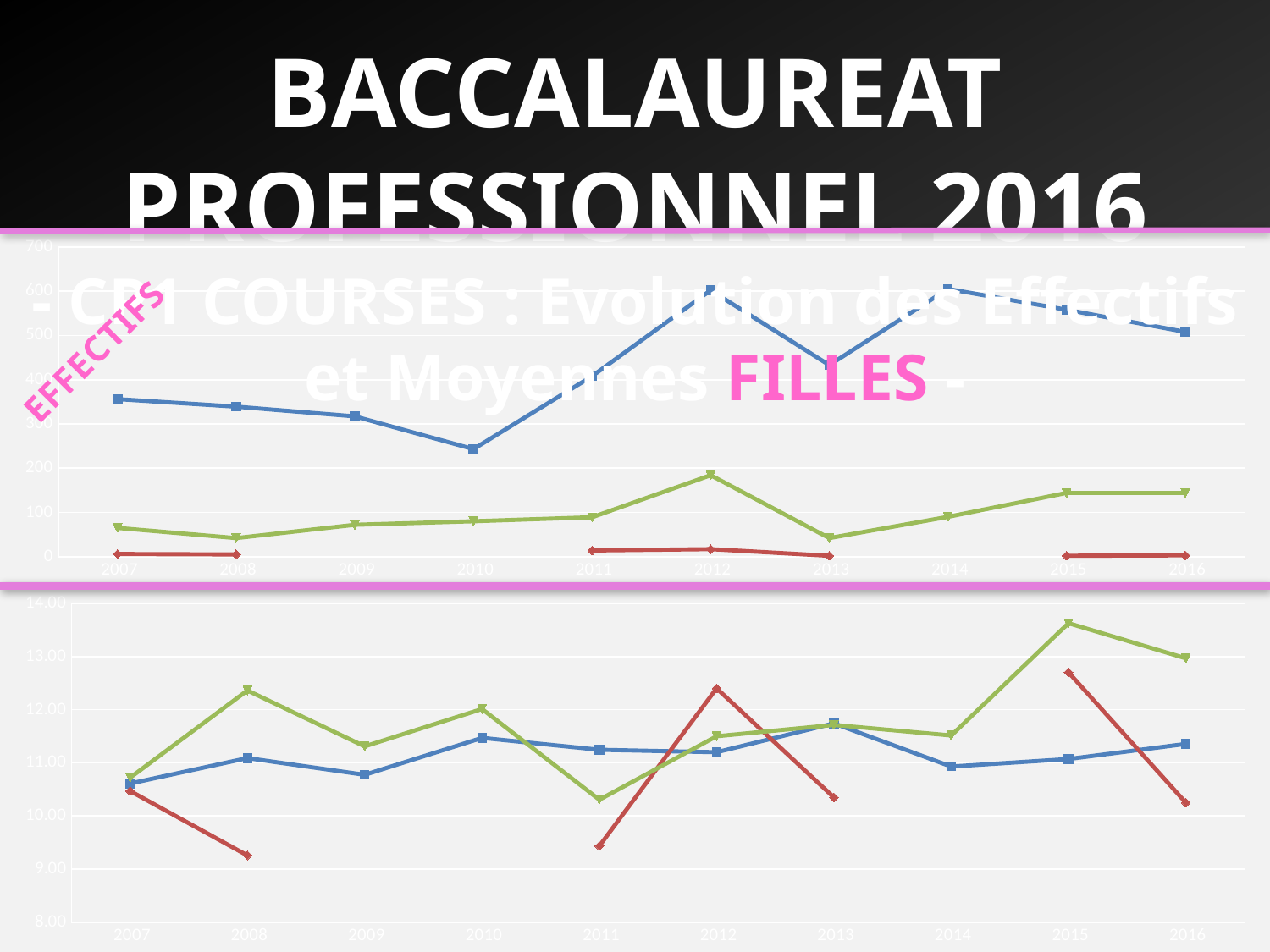
In the top chart, in which year does the blue line reach its lowest value? 2010 How many lines are plotted in the top chart? 3 In the top chart, is the value of the blue line in 2010 greater or less than 300? less In the top chart, in which year does the green line reach its highest value? 2012 What rotated label is written at the left of the top chart? EFFECTIFS In the bottom chart, in which year does the green line reach its highest value? 2015 In the top chart, is the value of the green line in 2012 greater or less than 100? greater In the top chart, does the blue line rise or fall from 2007 to 2010? fall In the bottom chart, which line is higher in 2012, the red line or the blue line? red line How many years are shown on the x axis of the bottom chart? 10 In the bottom chart, is the value of the red line in 2008 greater or less than 10.00? less What kind of chart is the top chart on the slide? line chart